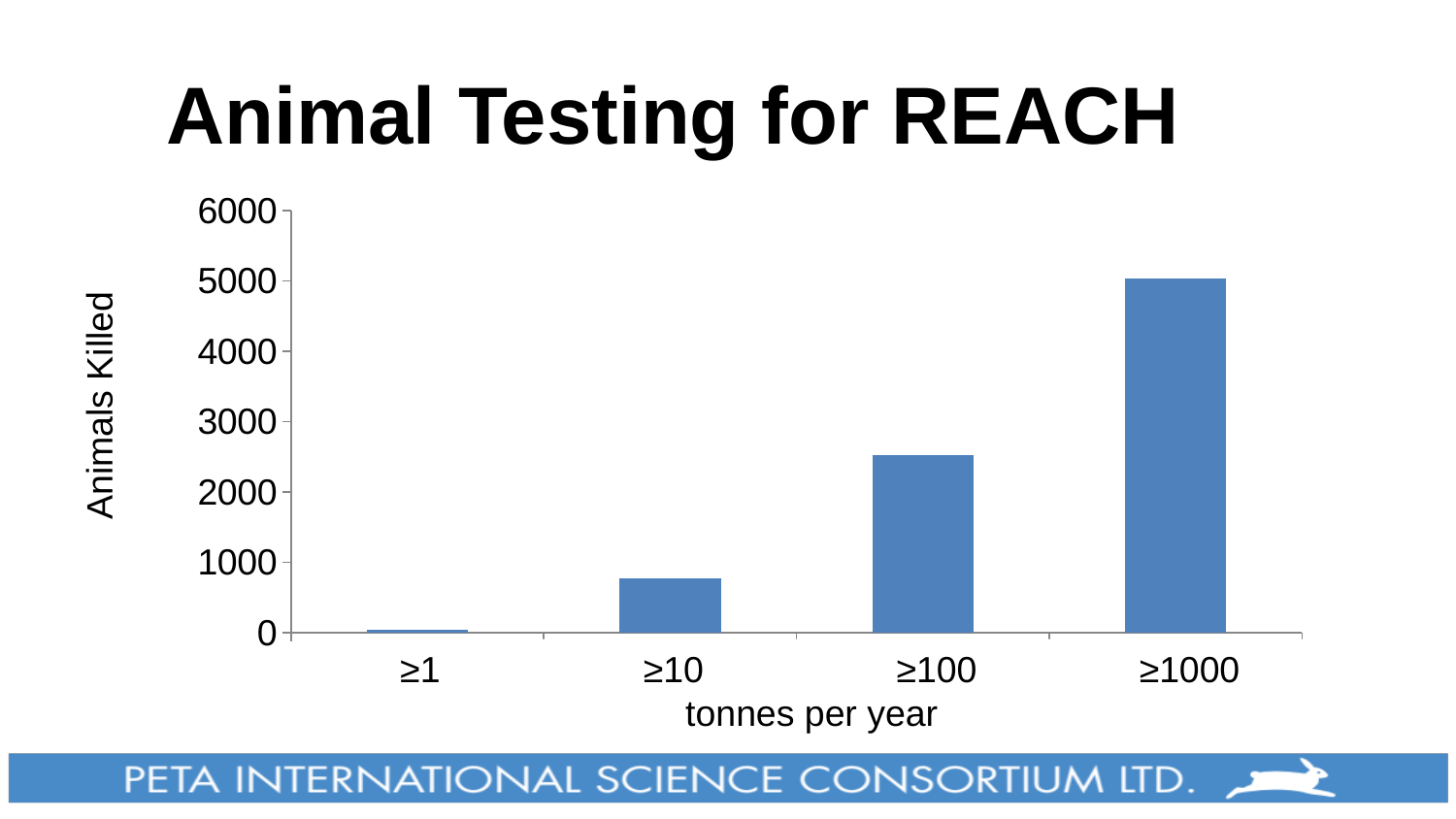
Which tonnage category has the lowest number of animals killed? ≥1 Do the values rise or fall as the tonnage per year increases along the x axis? rise Is the value for ≥100 tonnes per year greater or less than 2000? greater Which is larger, the value for ≥10 or the value for ≥100 tonnes per year? ≥100 What is the title of the chart on the slide? Animal Testing for REACH How many categories are shown on the x axis of the chart? 4 Is the value for ≥100 tonnes per year greater or less than 3000? less What is the label of the y axis of the chart? Animals Killed Is the value for ≥1000 tonnes per year greater or less than 4000? greater Which tonnage category has the highest number of animals killed? ≥1000 What kind of chart is shown on the slide? bar chart